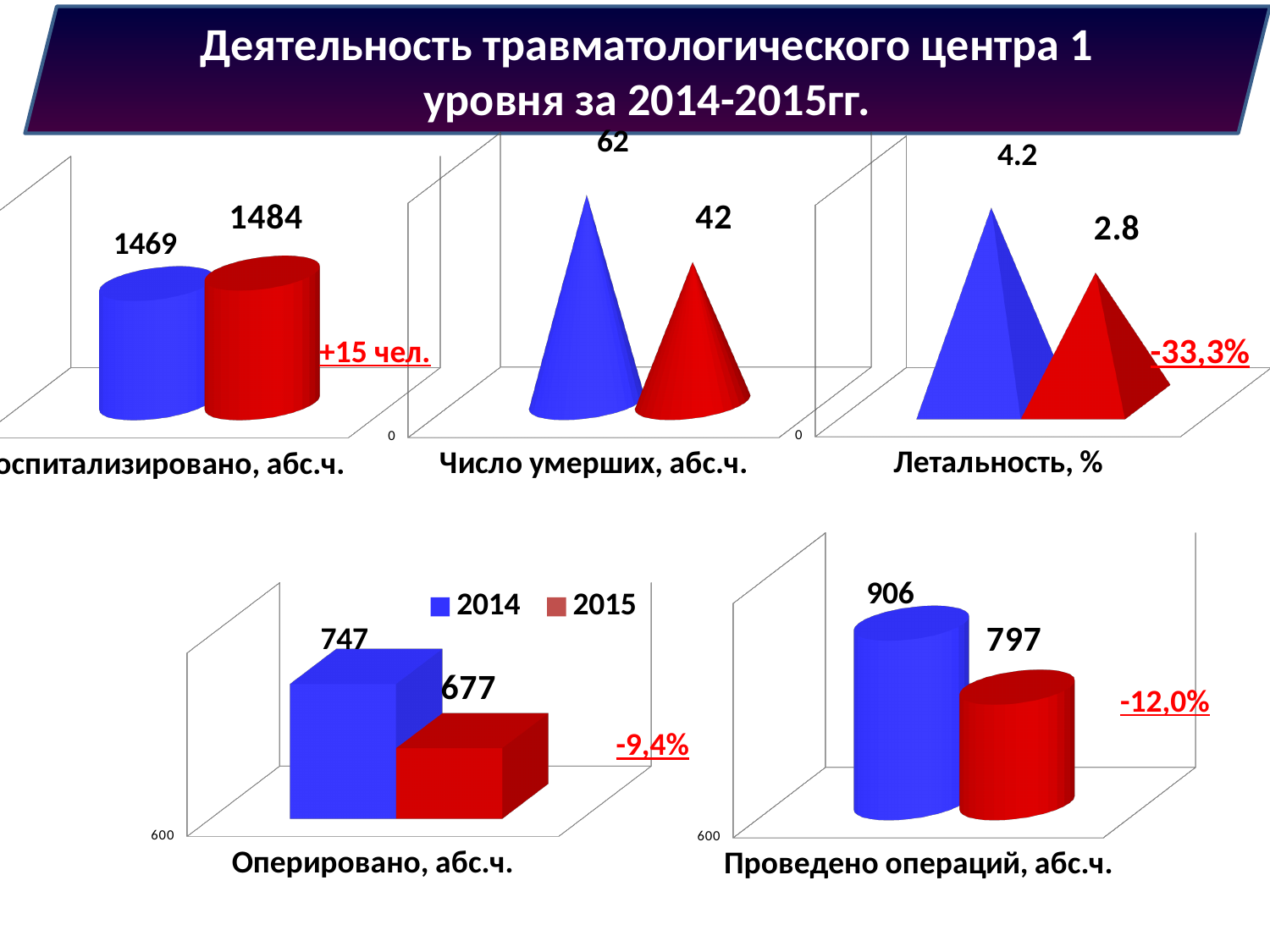
In the 'Оперировано, абс.ч.' chart, what is the value for 2014? 747 In the 'Число умерших, абс.ч.' chart, what is the difference between the 2014 and 2015 values? 20 In the 'Проведено операций, абс.ч.' chart, what is the difference between the 2014 and 2015 values? 109 In the 'Проведено операций, абс.ч.' chart, what is the value for 2015? 797 How many series does the legend on the slide list? 2 What colour represents 2014 in the legend? blue In the 'Число умерших, абс.ч.' chart, what is the value for 2014? 62 In the 'Оперировано, абс.ч.' chart, do the values rise or fall from 2014 to 2015? fall In the top-left chart (Госпитализировано, абс.ч.), which year has the higher value? 2015 In the 'Число умерших, абс.ч.' chart, what is the value for 2015? 42 In the 'Летальность, %' chart, which year has the lower value? 2015 In the 'Летальность, %' chart, what is the value for 2015? 2.8